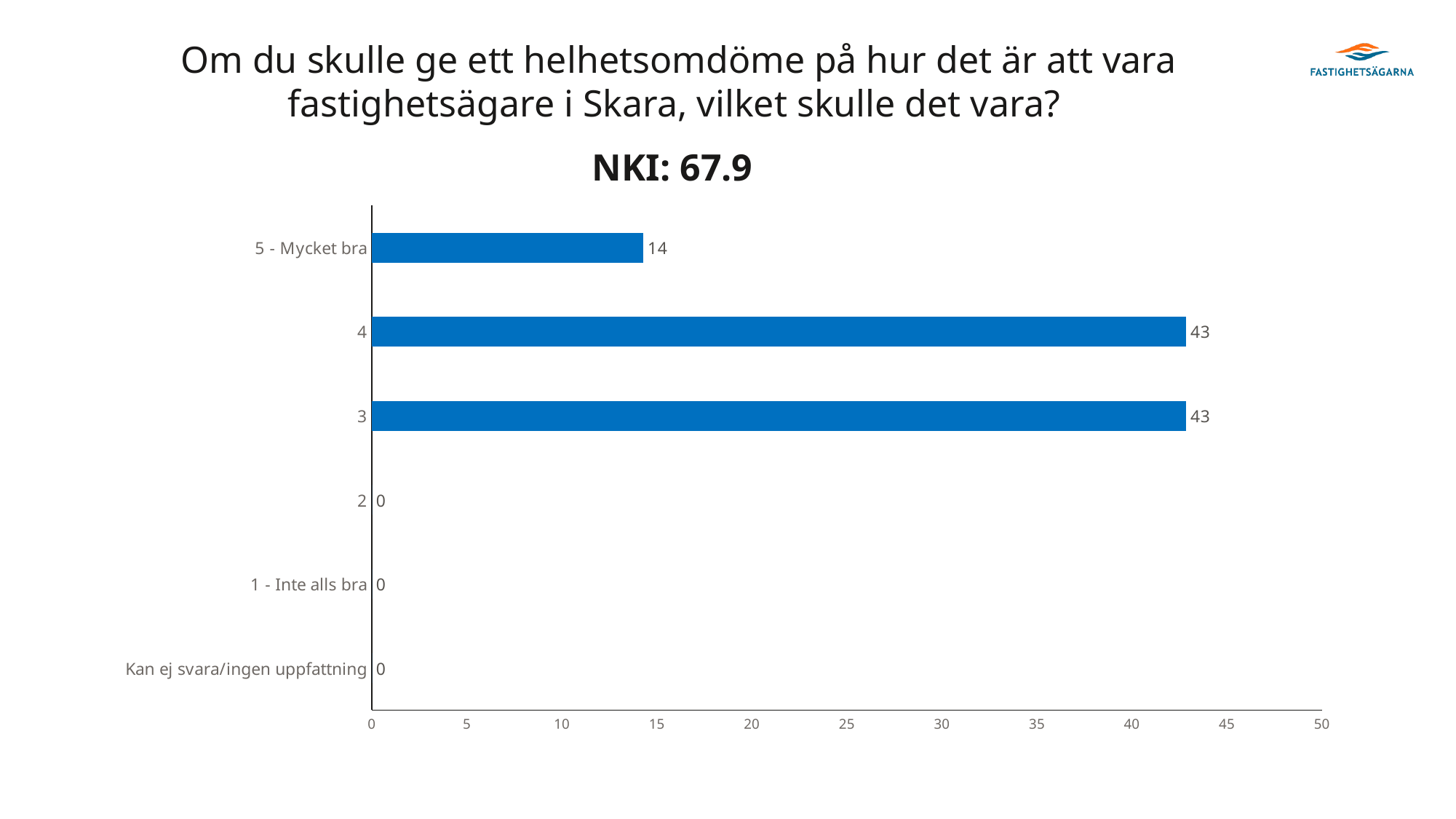
What is the value for category "3"? 43 Which is larger, the value for "5 - Mycket bra" or the value for "3"? 3 How many categories are shown on the chart? 6 What kind of chart is shown on the slide? bar chart Is the value for "5 - Mycket bra" greater or less than 20? less What is the value for "5 - Mycket bra"? 14 What is the NKI value shown above the chart? 67.9 What is the highest value shown on the x axis? 50 What is the difference between the value for "4" and the value for "5 - Mycket bra"? 29 What is the value for "Kan ej svara/ingen uppfattning"? 0 What is the value for category "4"? 43 What is the value for "1 - Inte alls bra"? 0